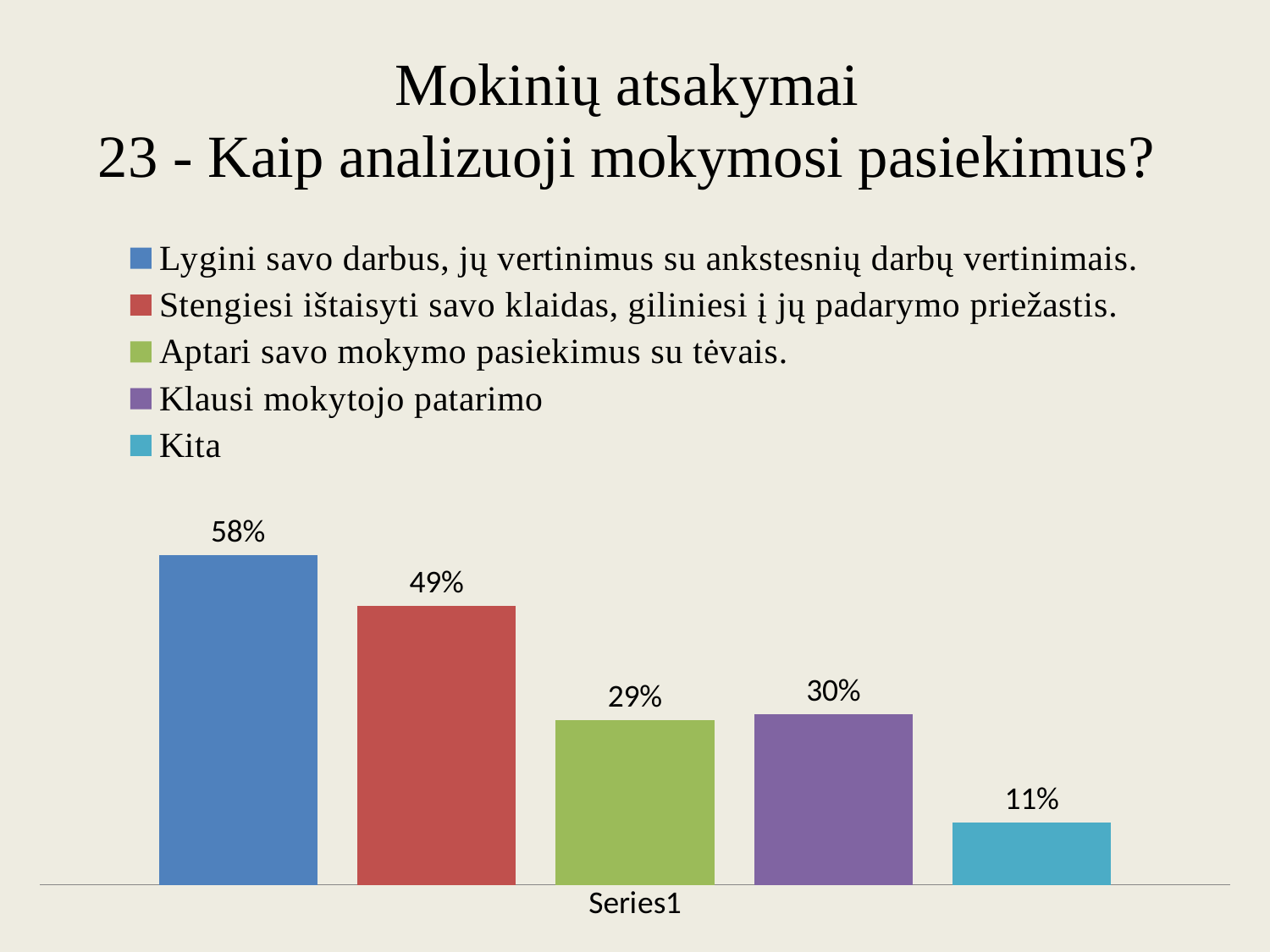
What kind of chart is shown on the slide? Bar chart What value is shown for "Lygini savo darbus, jų vertinimus su ankstesnių darbų vertinimais."? 58% What is the difference between the values for "Lygini savo darbus, jų vertinimus su ankstesnių darbų vertinimais." and "Stengiesi ištaisyti savo klaidas, giliniesi į jų padarymo priežastis."? 9% What value is shown for "Stengiesi ištaisyti savo klaidas, giliniesi į jų padarymo priežastis."? 49% How many entries does the legend list? 5 What value is shown for "Klausi mokytojo patarimo"? 30% How many bars are plotted in the chart? 5 Which legend entry has the lowest value? Kita What value is shown for "Kita"? 11% Which legend entry has the highest value? Lygini savo darbus, jų vertinimus su ankstesnių darbų vertinimais. What value is shown for "Aptari savo mokymo pasiekimus su tėvais."? 29% Which is larger: the value for "Klausi mokytojo patarimo" or the value for "Kita"? Klausi mokytojo patarimo